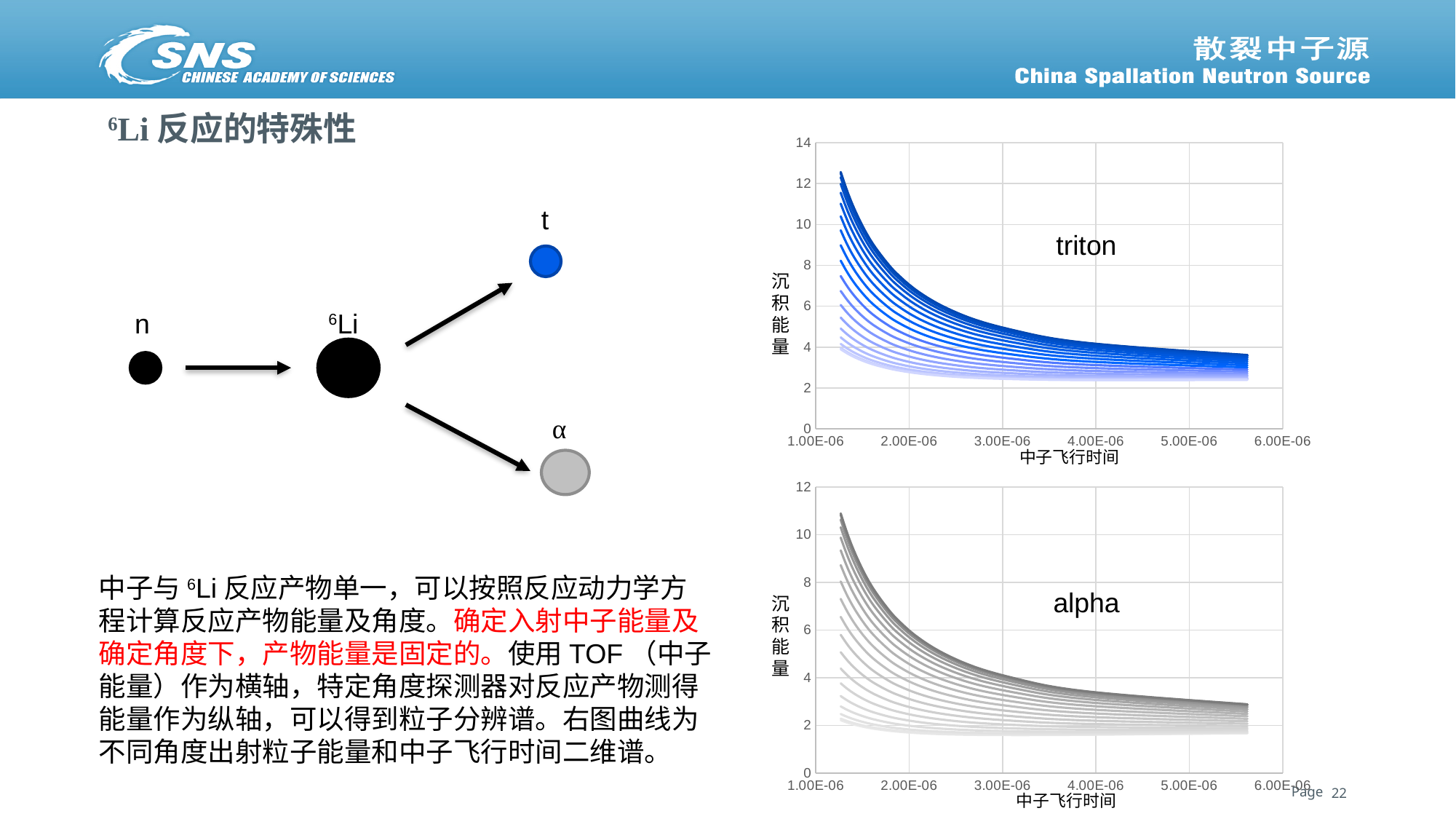
How many charts are shown on the slide? 2 In the top chart (triton), is the highest starting value of the curves greater or less than 10? greater What is the x-axis label of the bottom chart (alpha)? 中子飞行时间 In the top chart (triton), do the curves rise or fall as the neutron flight time (中子飞行时间) increases? fall What kind of chart is the top chart labelled "triton"? line chart In the bottom chart (alpha), is the value of the lowest curve at 4.00E-06 greater or less than 4? less In the bottom chart (alpha), do the curves rise or fall as the neutron flight time (中子飞行时间) increases? fall What kind of chart is the bottom chart labelled "alpha"? line chart In the bottom chart (alpha), is the highest starting value of the curves greater or less than 10? greater What is the maximum value shown on the y axis of the top chart (triton)? 14